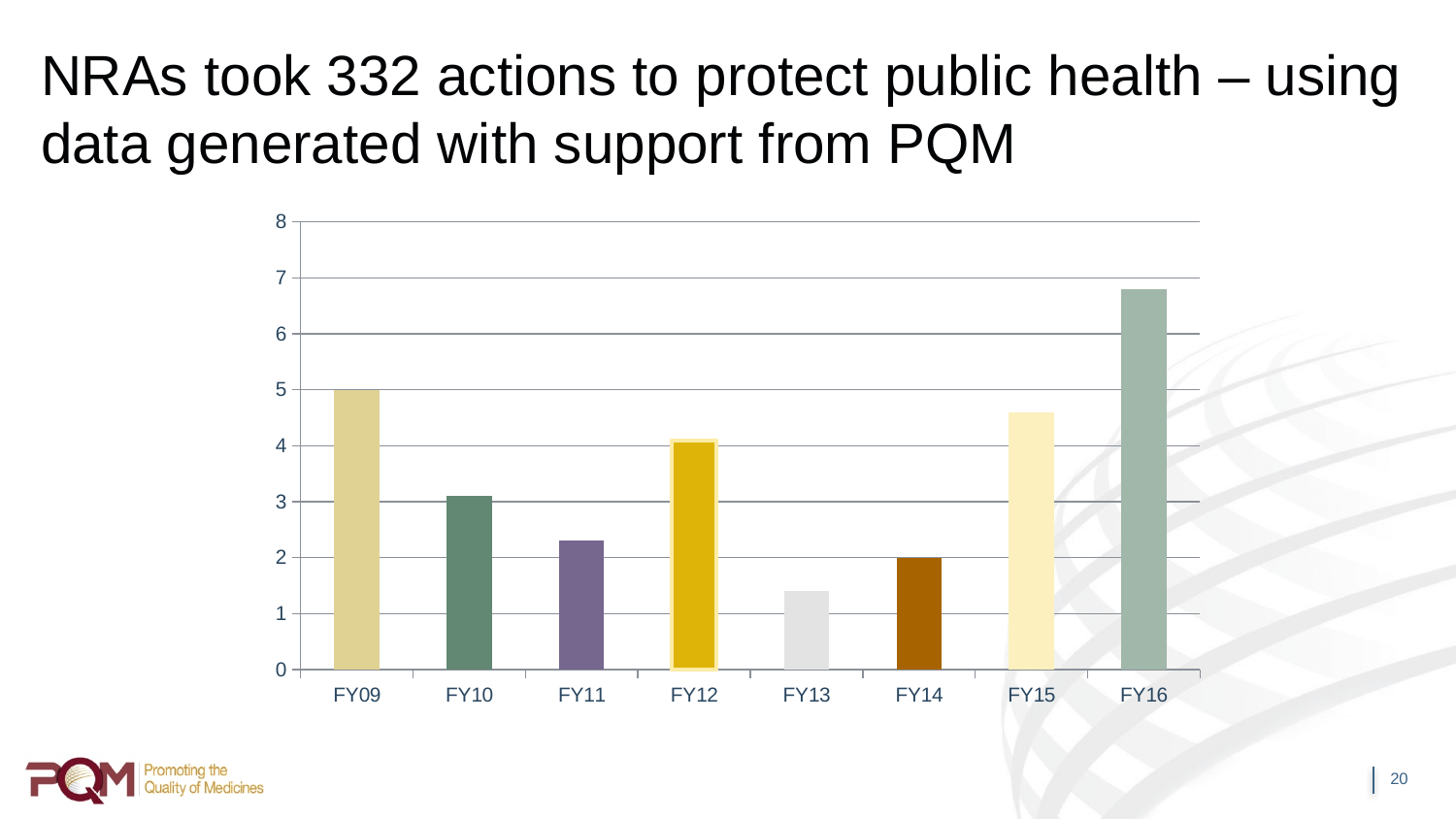
Which is larger, the value for FY12 or the value for FY15? FY15 Which fiscal year has the lowest bar? FY13 Is the value for FY13 greater or less than 2? less Which is larger, the value for FY10 or the value for FY11? FY10 Which fiscal year has the highest bar? FY16 How many fiscal years are plotted on the chart? 8 Is the value for FY15 greater or less than 4? greater What kind of chart is shown on the slide? bar chart What is the highest value shown on the vertical axis? 8 Is the value for FY16 greater or less than 6? greater What is the value for FY14? 2 What is the value for FY09? 5